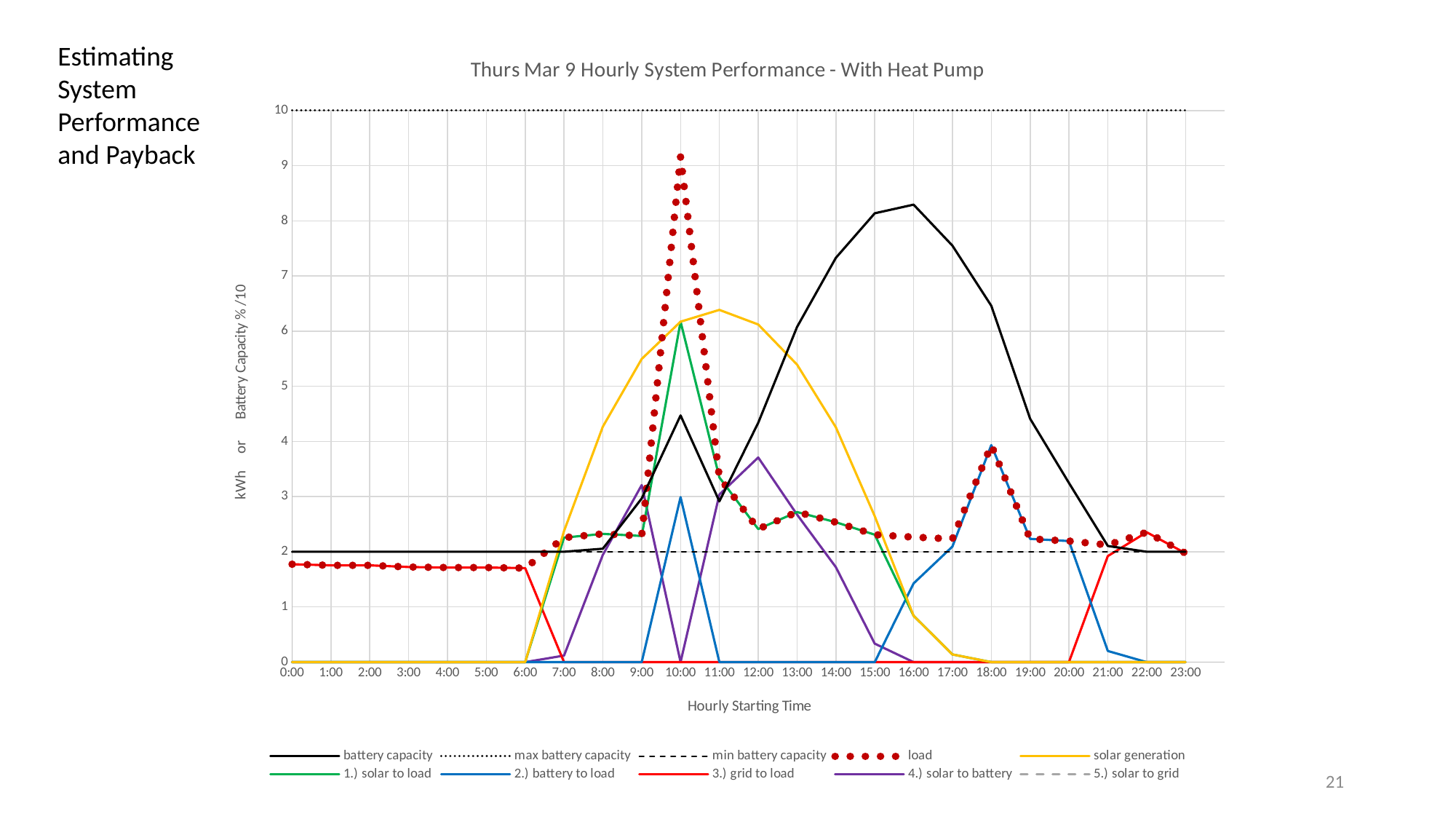
At which hourly starting time is the load highest? 10:00 At which hourly starting time does battery capacity reach its highest value? 16:00 How many series does the chart's legend list? 10 What is the title of the chart? Thurs Mar 9 Hourly System Performance - With Heat Pump What value does the max battery capacity line sit at? 10 What type of chart is shown on the slide? line chart What value does the min battery capacity line sit at? 2 Is the solar generation at 11:00 greater or less than 6? greater Does the battery capacity rise or fall between 11:00 and 16:00? rise How many hourly time points are shown along the x axis? 24 Is the load at 10:00 greater or less than 8? greater Which is larger at 18:00, the battery to load value or the solar generation value? battery to load